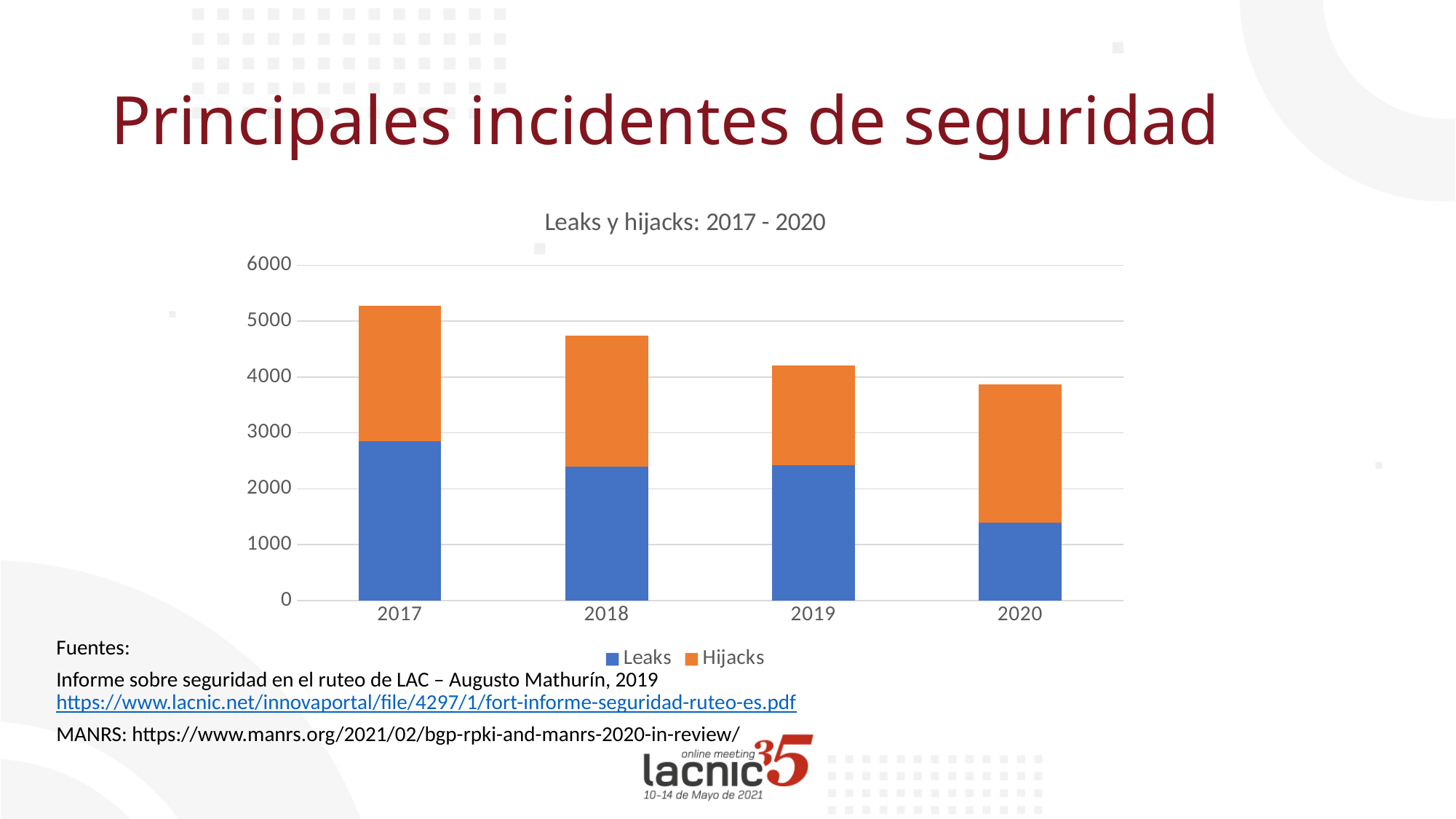
Which is larger, the Leaks value for 2017 or the Leaks value for 2020? 2017 Which colour represents Hijacks in the chart? Orange Is the total bar height for 2017 greater or less than 5000? greater How many years are shown on the x axis of the chart? 4 Which year has the shortest stacked bar (lowest total of leaks and hijacks)? 2020 How many series does the legend list? 2 Is the total bar height for 2020 greater or less than 4000? less What is the title of the chart? Leaks y hijacks: 2017 - 2020 Which year has the tallest stacked bar (highest total of leaks and hijacks)? 2017 Do the total bar heights rise or fall from 2017 to 2020? Fall What kind of chart is shown on the slide? Stacked bar chart Is the Leaks value for 2020 greater or less than 2000? less